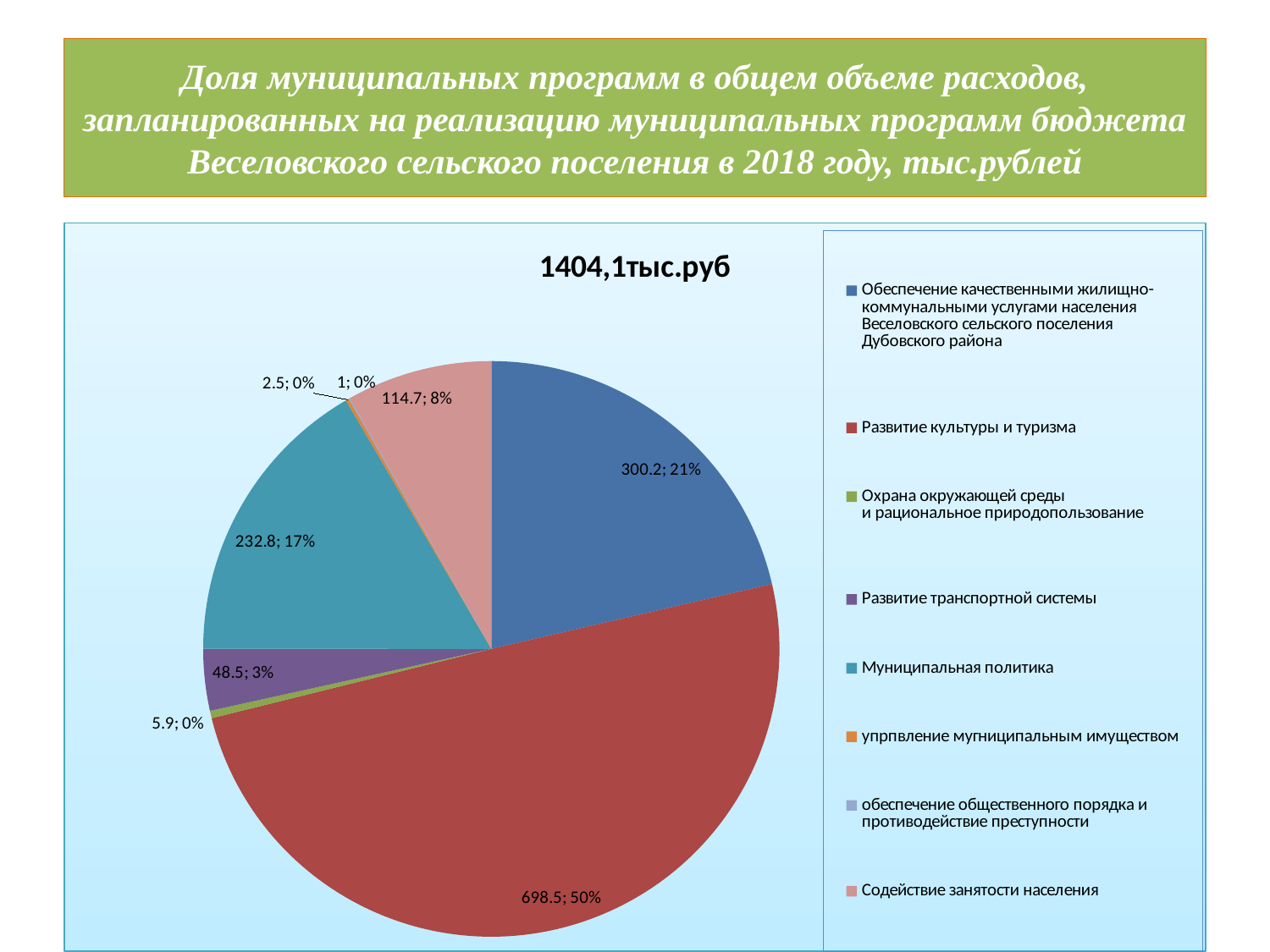
What share of the pie does Развитие культуры и туризма take? 50% What is the value shown for Развитие культуры и туризма? 698.5 Which category has the smallest slice of the pie? обеспечение общественного порядка и противодействие преступности What percentage is shown for Содействие занятости населения? 8% What is the title shown above the pie chart? 1404,1тыс.руб What kind of chart is shown on the slide? pie chart What is the difference between the values for Развитие культуры и туризма and Муниципальная политика? 465.7 How many categories does the legend list? 8 What is the value shown for Муниципальная политика? 232.8 Which is larger: the value for Муниципальная политика or the value for Содействие занятости населения? Муниципальная политика What is the value shown for Развитие транспортной системы? 48.5 Which category has the largest slice of the pie? Развитие культуры и туризма